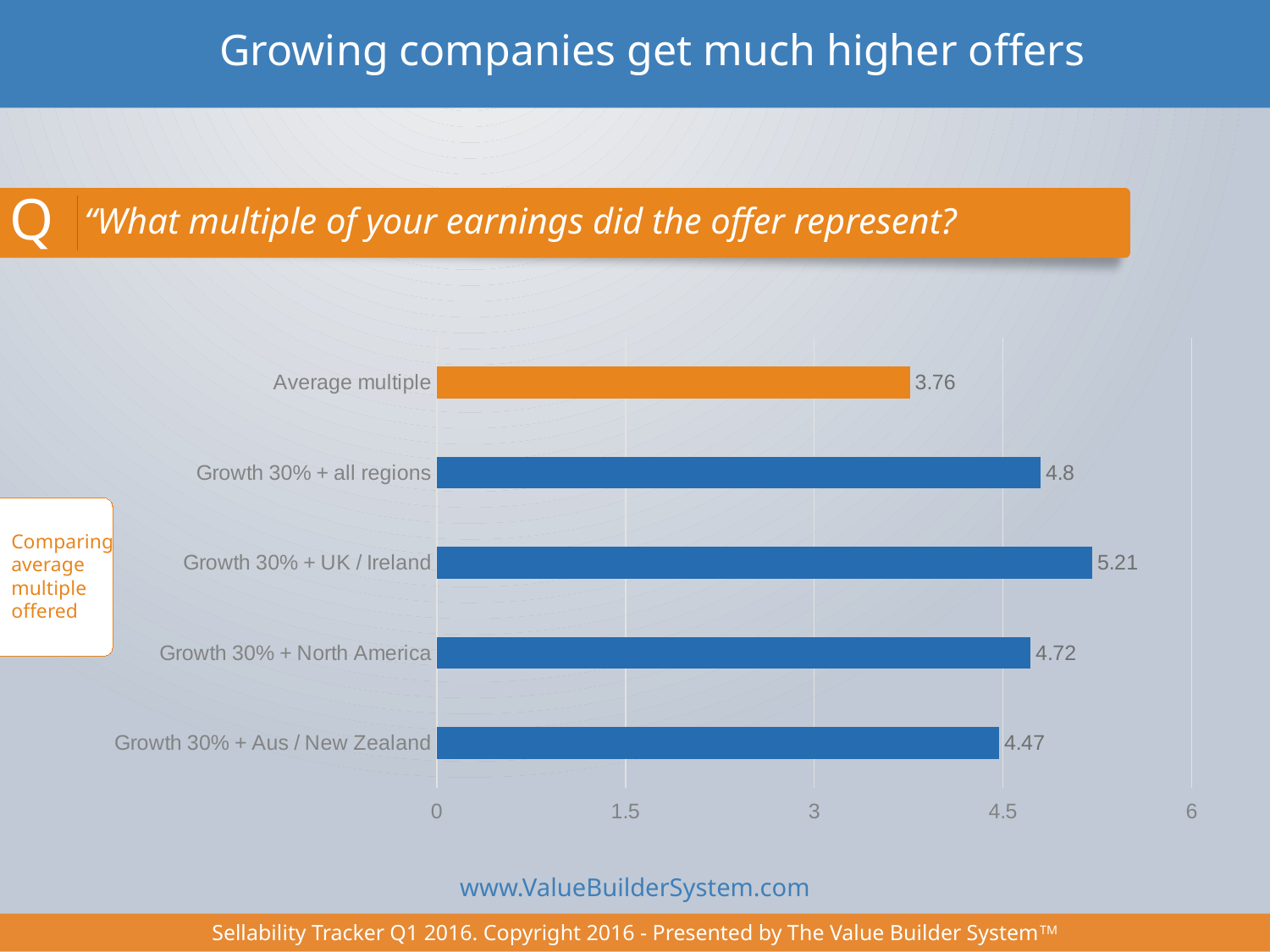
Which category has the lowest value? Average multiple What is the value for Average multiple? 3.76 What is the value for Growth 30% + North America? 4.72 How many categories are shown in the chart? 5 Is the value for Growth 30% + Aus / New Zealand greater or less than 4.5? less What is the difference between the values for Growth 30% + UK / Ireland and Average multiple? 1.45 Which bar is coloured orange rather than blue? Average multiple What is the value for Growth 30% + Aus / New Zealand? 4.47 What is the value for Growth 30% + UK / Ireland? 5.21 What kind of chart is shown on the slide? bar chart Which is larger, the value for Growth 30% + all regions or Growth 30% + North America? Growth 30% + all regions Which category has the highest value? Growth 30% + UK / Ireland